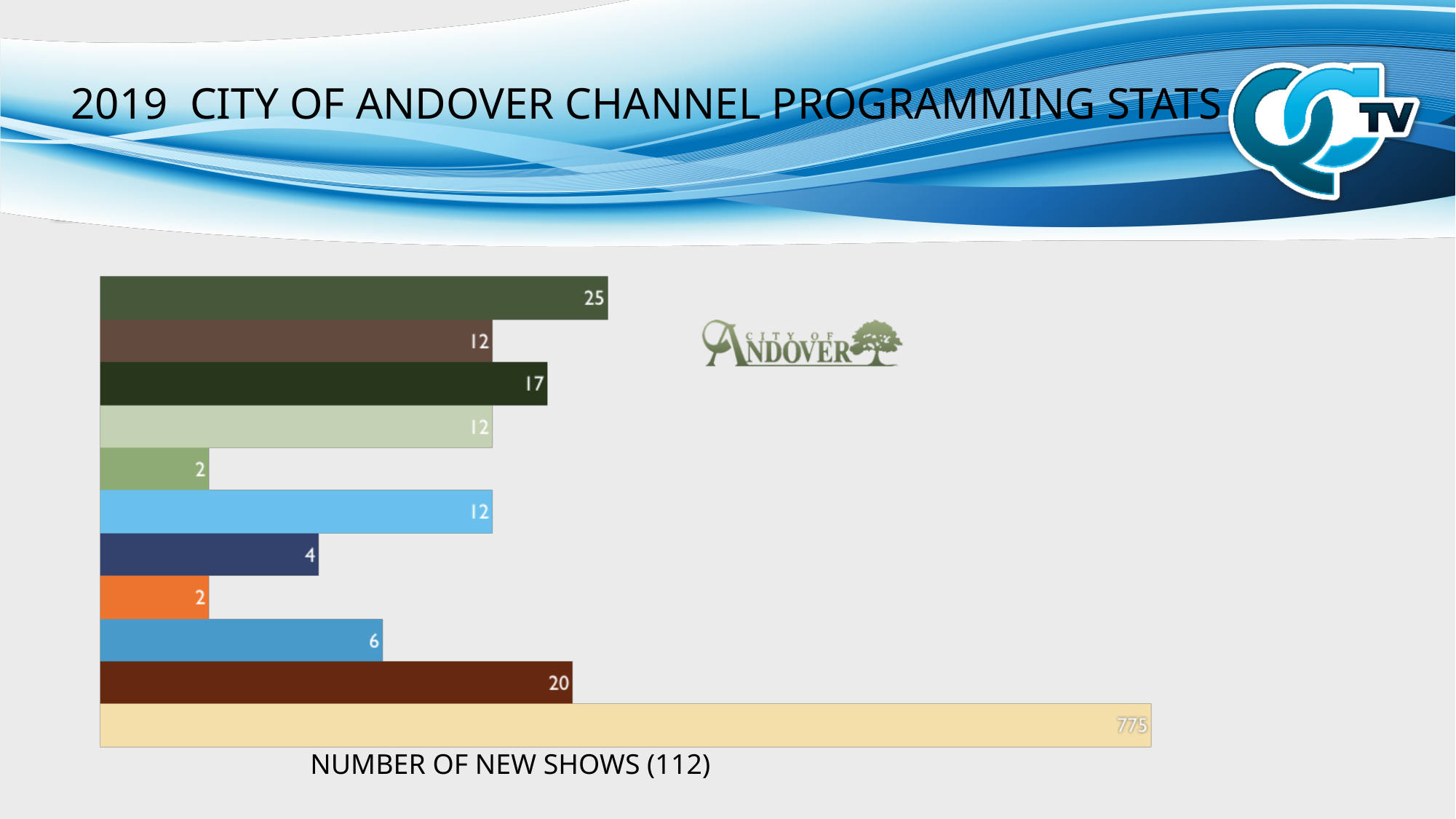
What is the difference between the largest value (775) and the topmost bar's value (25)? 750 What is the largest value shown on the chart? 775 What is the value of the bottom (pale yellow) bar in the chart? 775 What text appears directly below the chart? NUMBER OF NEW SHOWS (112) What is the value of the topmost bar in the chart? 25 How many bars does the chart contain? 11 What is the value of the dark red bar, second from the bottom? 20 What kind of chart is shown on the slide? bar chart What is the value of the orange bar? 2 Which is larger: the value of the topmost bar or the value of the dark red bar second from the bottom? the topmost bar (25) How many bars in the chart have a value of 12? 3 What is the smallest value shown on the chart? 2